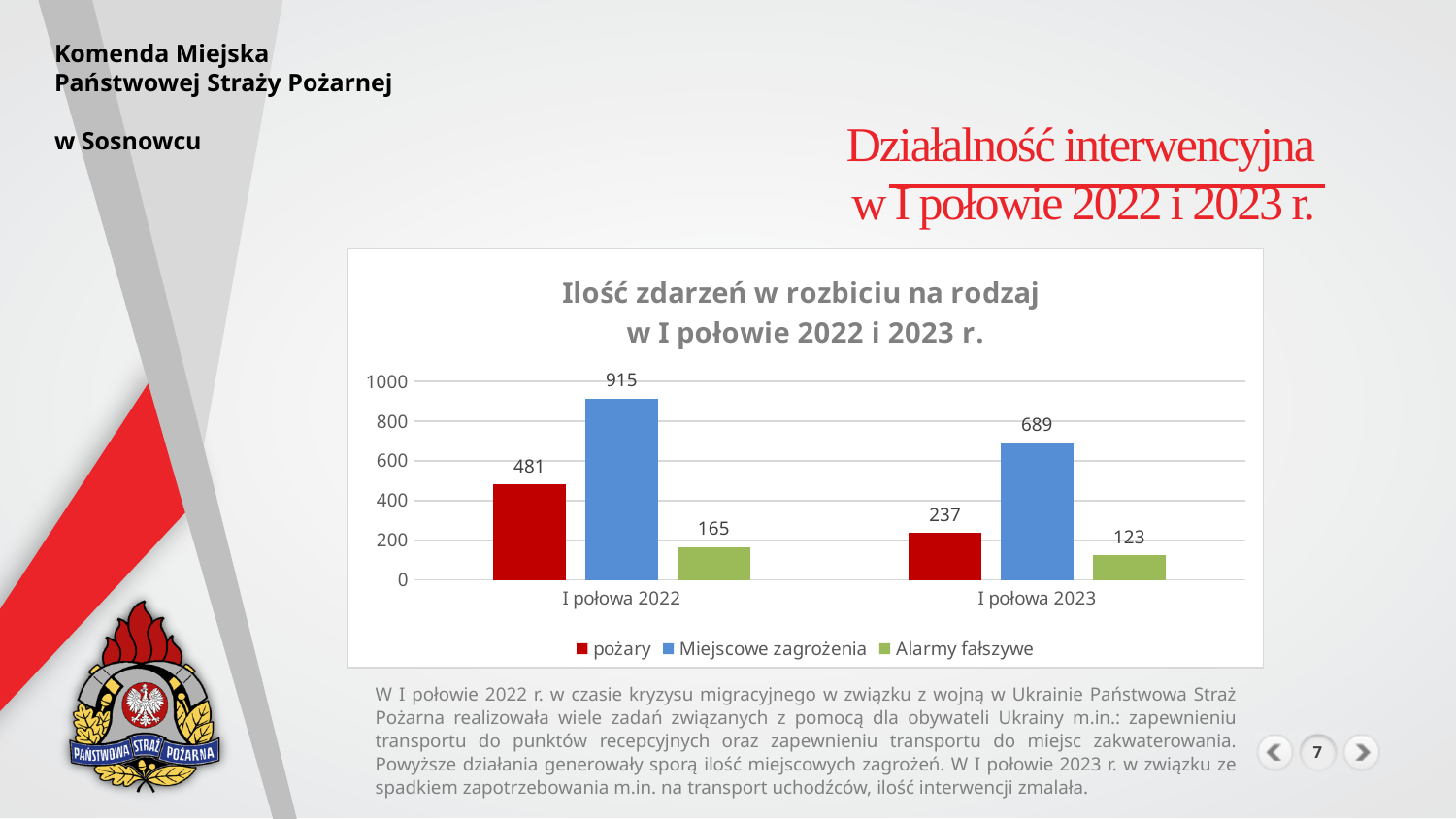
Which is larger: pożary in I połowa 2022 or pożary in I połowa 2023? I połowa 2022 Which series has the highest value in I połowa 2023? Miejscowe zagrożenia Which series has the lowest value in I połowa 2022? Alarmy fałszywe What is the difference between Miejscowe zagrożenia in I połowa 2022 and I połowa 2023? 226 What is the title of the chart? Ilość zdarzeń w rozbiciu na rodzaj w I połowie 2022 i 2023 r. What is the value for pożary in I połowa 2022? 481 How many categories are shown on the x axis? 2 What is the value for Miejscowe zagrożenia in I połowa 2023? 689 What kind of chart is shown on the slide? bar chart What is the value for Alarmy fałszywe in I połowa 2022? 165 Is the value for Miejscowe zagrożenia in I połowa 2022 greater or less than 800? greater How many series does the legend list? 3